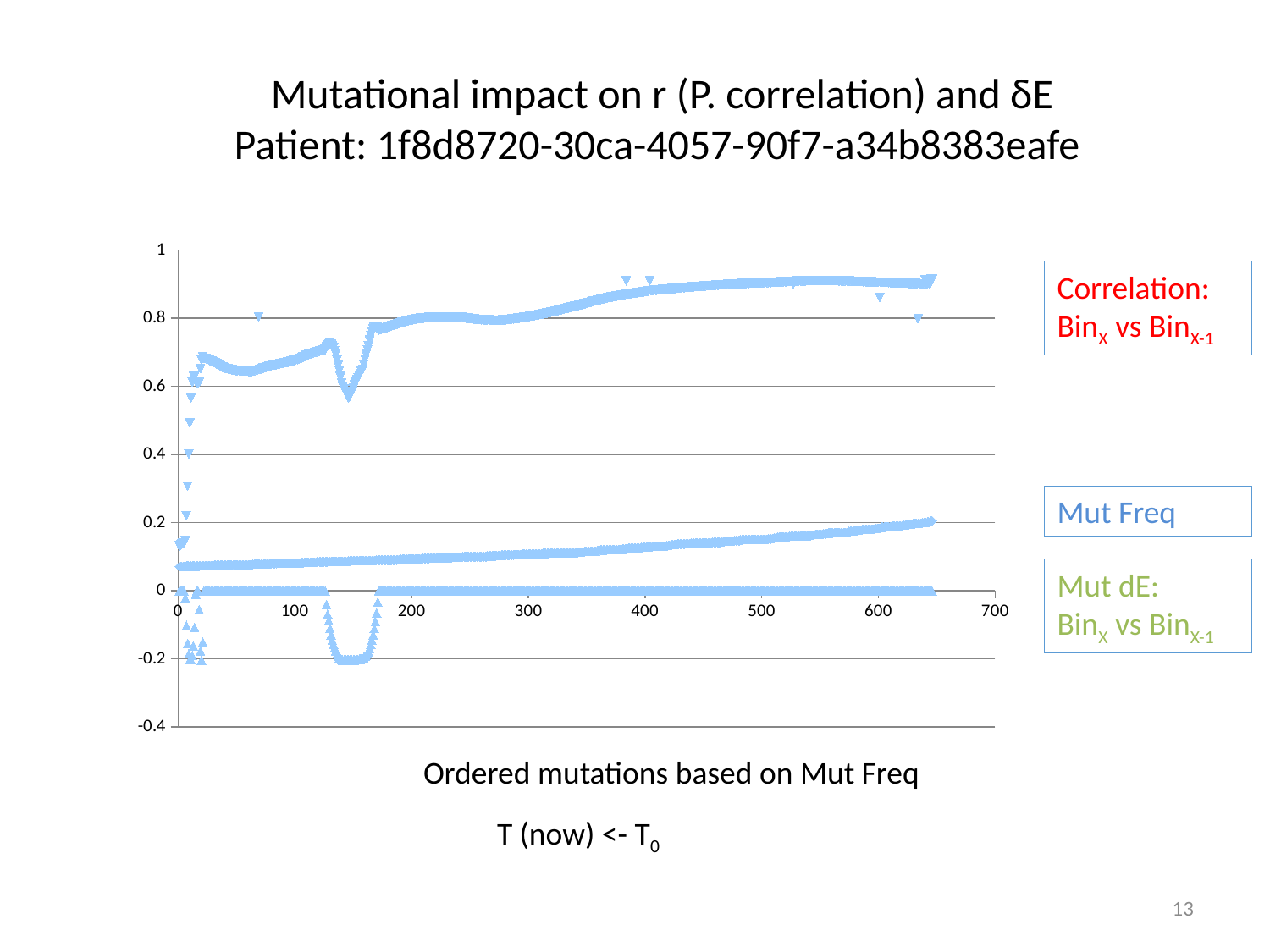
At x = 400, which series has the larger value, Correlation or Mut Freq? Correlation Does the Mut Freq series rise or fall as x increases from 0 to 650? rise What kind of chart is shown on the slide? scatter chart Is the Correlation value at x = 100 greater or less than 0.8? less Which of the three series has the highest values on the chart? Correlation Is the Mut dE value at x = 300 greater or less than -0.2? greater Is the Mut dE value at x = 150 greater or less than 0? less What is the x-axis label of the chart? Ordered mutations based on Mut Freq What is the highest value shown on the y axis of the chart? 1 What is the title of the chart on the slide? Mutational impact on r (P. correlation) and δE Patient: 1f8d8720-30ca-4057-90f7-a34b8383eafe